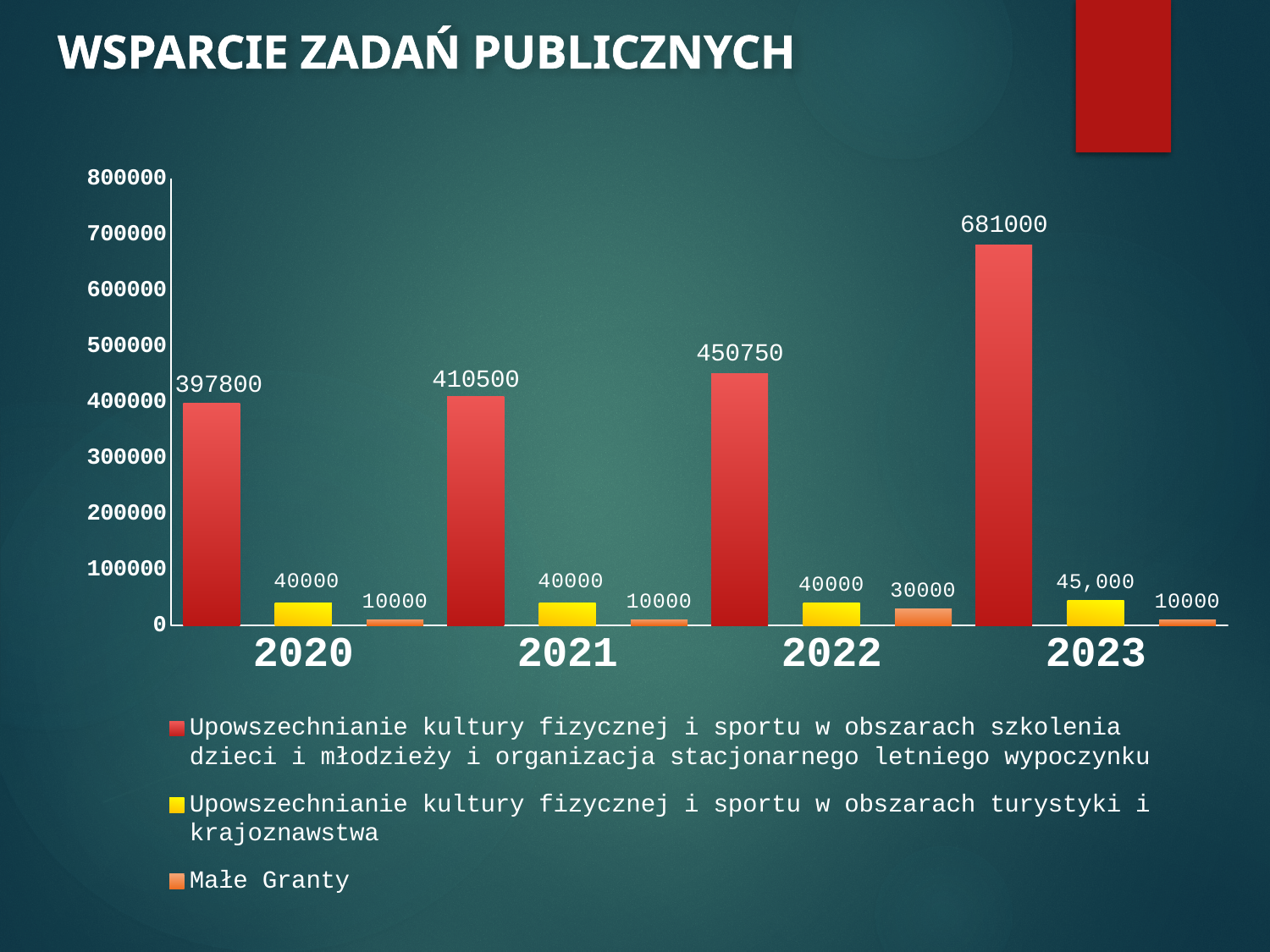
Is the red series value for 2022 greater or less than 400000? greater In which year is the red series (szkolenia dzieci i młodzieży) lowest? 2020 In which year is the red series (szkolenia dzieci i młodzieży) highest? 2023 Does the red series rise or fall from 2020 to 2023? rise What is the value for the red series (Upowszechnianie kultury fizycznej i sportu w obszarach szkolenia dzieci i młodzieży...) in 2023? 681000 Which is larger: the red series value in 2021 or in 2020? 2021 What is the value for Małe Granty in 2022? 30000 What is the difference between the red series values for 2023 and 2022? 230250 What is the value for the yellow series (turystyki i krajoznawstwa) in 2023? 45,000 What kind of chart is shown on the slide? bar chart How many series does the legend list? 3 How many years are shown on the x axis? 4